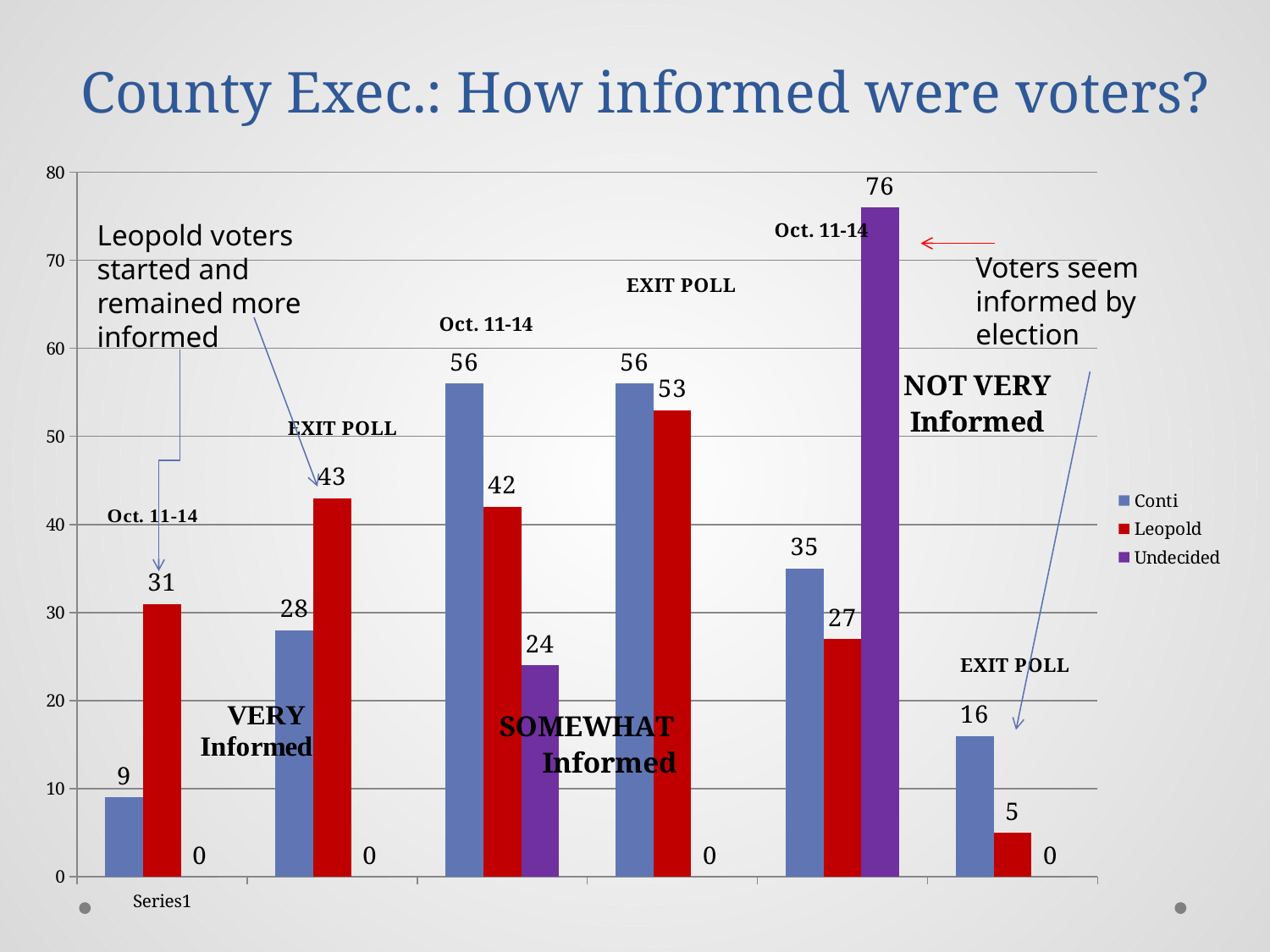
How many series does the legend list? 3 What is the Leopold value for Very Informed in the Oct. 11-14 poll? 31 What is the Leopold value for Not Very Informed in the Exit Poll? 5 What kind of chart is shown on the slide? Bar chart Which series has the highest value for Not Very Informed in the Oct. 11-14 poll? Undecided What is the title of the slide? County Exec.: How informed were voters? What is the Undecided value for Not Very Informed in the Oct. 11-14 poll? 76 Which is larger for Somewhat Informed in the Oct. 11-14 poll, Conti or Leopold? Conti What is the Conti value for Somewhat Informed in the Exit Poll? 56 What colour are the Undecided bars? Purple Which series has the lowest value for Very Informed in the Oct. 11-14 poll? Undecided What is the difference between the Leopold and Conti values for Very Informed in the Exit Poll? 15